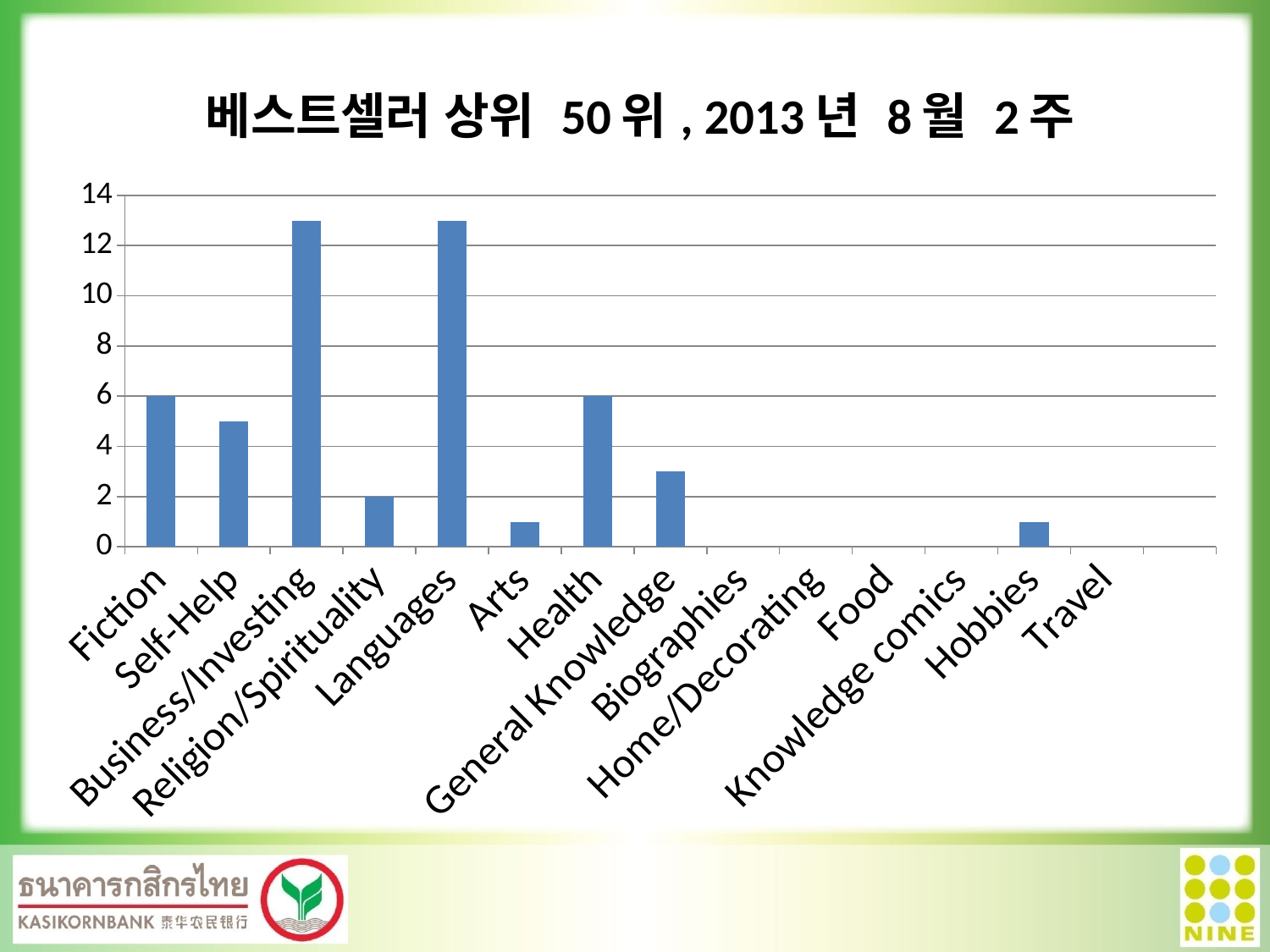
What colour are the bars in the chart? blue Which is larger, the value for Business/Investing or the value for Health? Business/Investing How many categories are shown on the x axis of the chart? 14 What is the difference between the values for Fiction and Religion/Spirituality? 4 What kind of chart is shown on the slide? bar chart Is the value for Arts greater or less than 2? less What is the value for Biographies? 0 What is the value for Religion/Spirituality? 2 Is the value for Business/Investing greater or less than 12? greater Is the value for Self-Help greater or less than 4? greater What is the value for Health? 6 What is the value for Fiction? 6